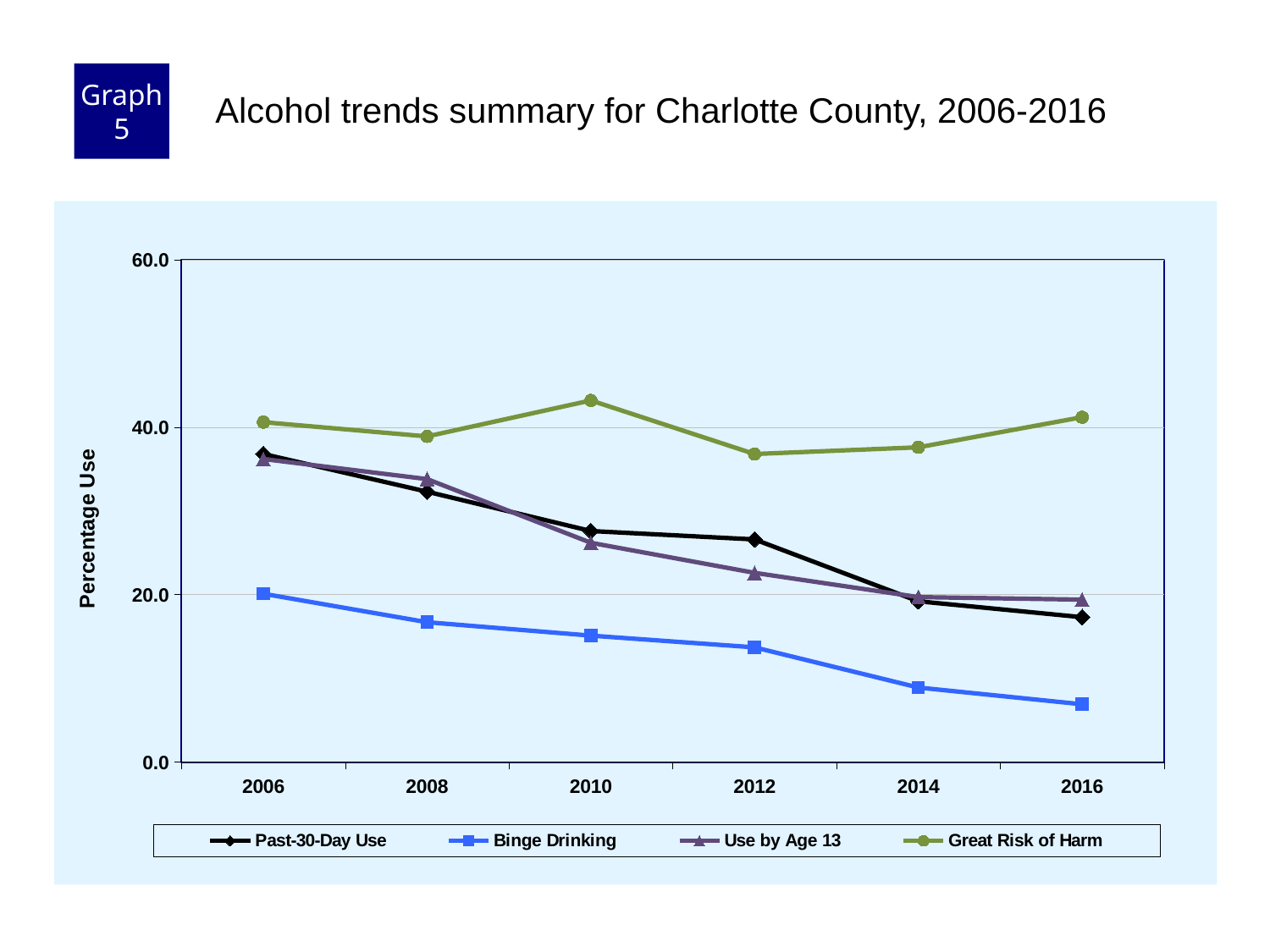
Which series has the lowest value in 2016? Binge Drinking Does the Binge Drinking line rise or fall from 2006 to 2016? Falls Does the Past-30-Day Use line rise or fall from 2006 to 2016? Falls Which series has the highest value in 2016? Great Risk of Harm Is the value for Great Risk of Harm in 2010 greater or less than 40.0? greater What kind of chart is shown on the slide? Line chart Is the value for Binge Drinking in 2016 greater or less than 20.0? less Is the value for Great Risk of Harm in 2012 greater or less than 40.0? less How many years are plotted along the x axis? 6 How many series does the legend list? 4 In 2012, which is larger: Past-30-Day Use or Use by Age 13? Past-30-Day Use What is the label on the y axis? Percentage Use